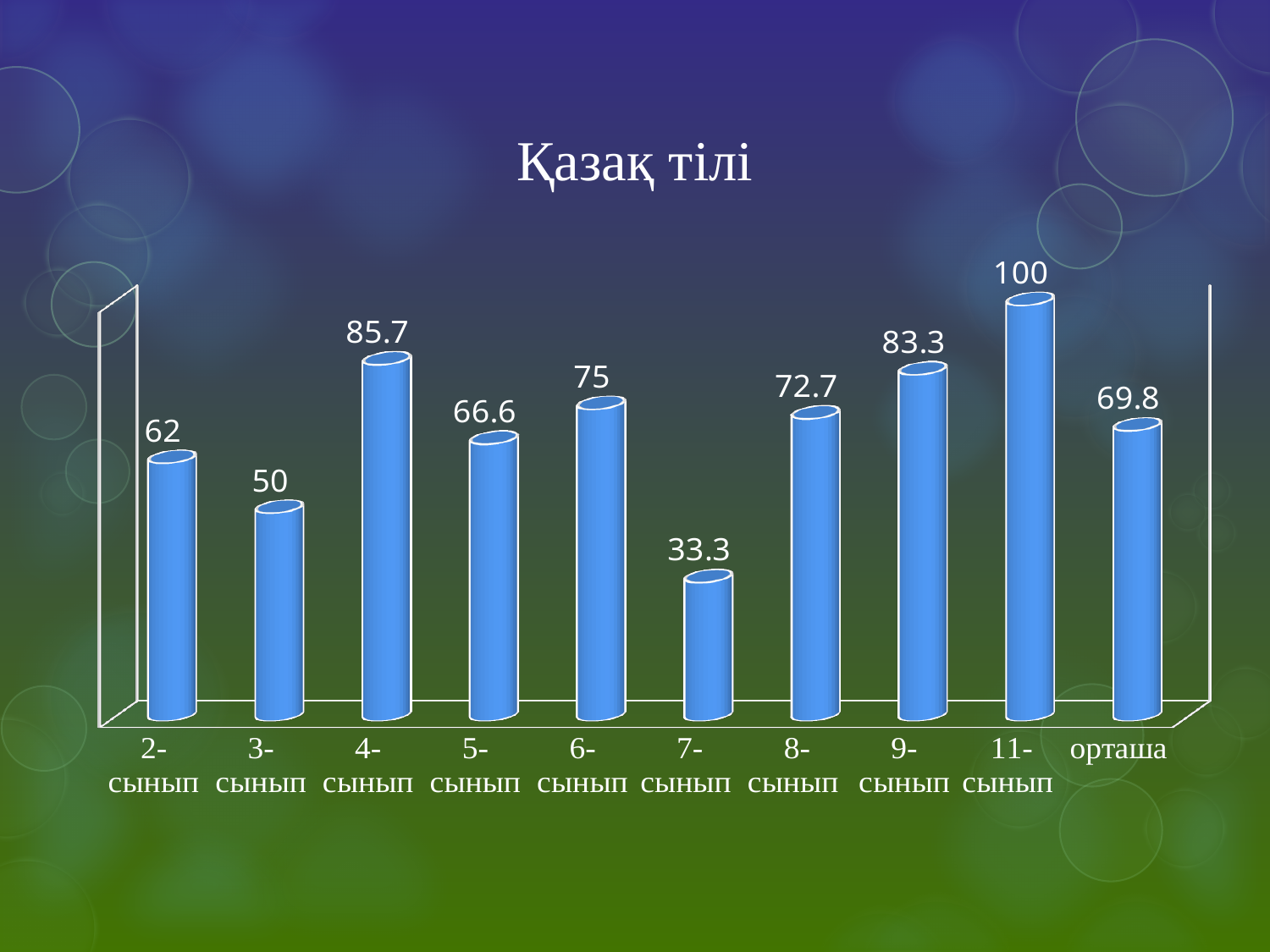
What is the value for орташа? 69.8 Which is larger, the value for 6-сынып or the value for 5-сынып? 6-сынып Which category has the lowest value? 7-сынып What is the value for 4-сынып? 85.7 How many categories are shown on the x axis? 10 Which category has the highest value? 11-сынып What is the title of the chart? Қазақ тілі What is the difference between the values for 11-сынып and 3-сынып? 50 What is the value for 7-сынып? 33.3 Which is larger, the value for 2-сынып or the value for 8-сынып? 8-сынып What is the difference between the values for 9-сынып and 8-сынып? 10.6 What kind of chart is this? bar chart